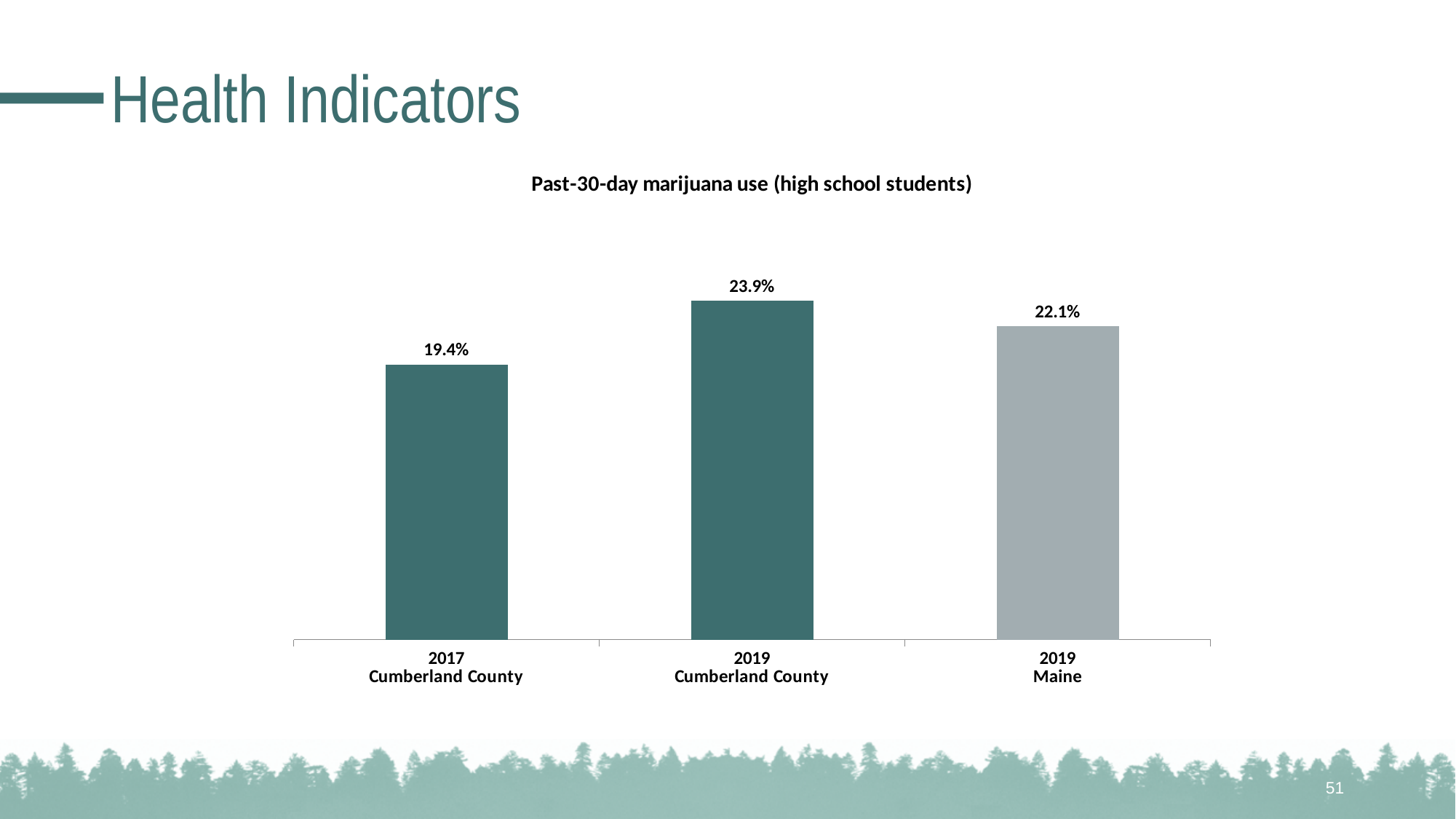
How many bars are shown in the chart? 3 Did the value for Cumberland County rise or fall from 2017 to 2019? Rise What is the title of the chart? Past-30-day marijuana use (high school students) What kind of chart is shown on the slide? Bar chart What is the value for 2019 Maine? 22.1% What is the difference between the 2019 Cumberland County value and the 2019 Maine value? 1.8% What is the value for 2019 Cumberland County? 23.9% What is the value for 2017 Cumberland County? 19.4% What is the difference between the 2019 Cumberland County value and the 2017 Cumberland County value? 4.5% Which is larger, the value for 2019 Cumberland County or the value for 2019 Maine? 2019 Cumberland County Which category has the lowest value? 2017 Cumberland County Which category has the highest value? 2019 Cumberland County